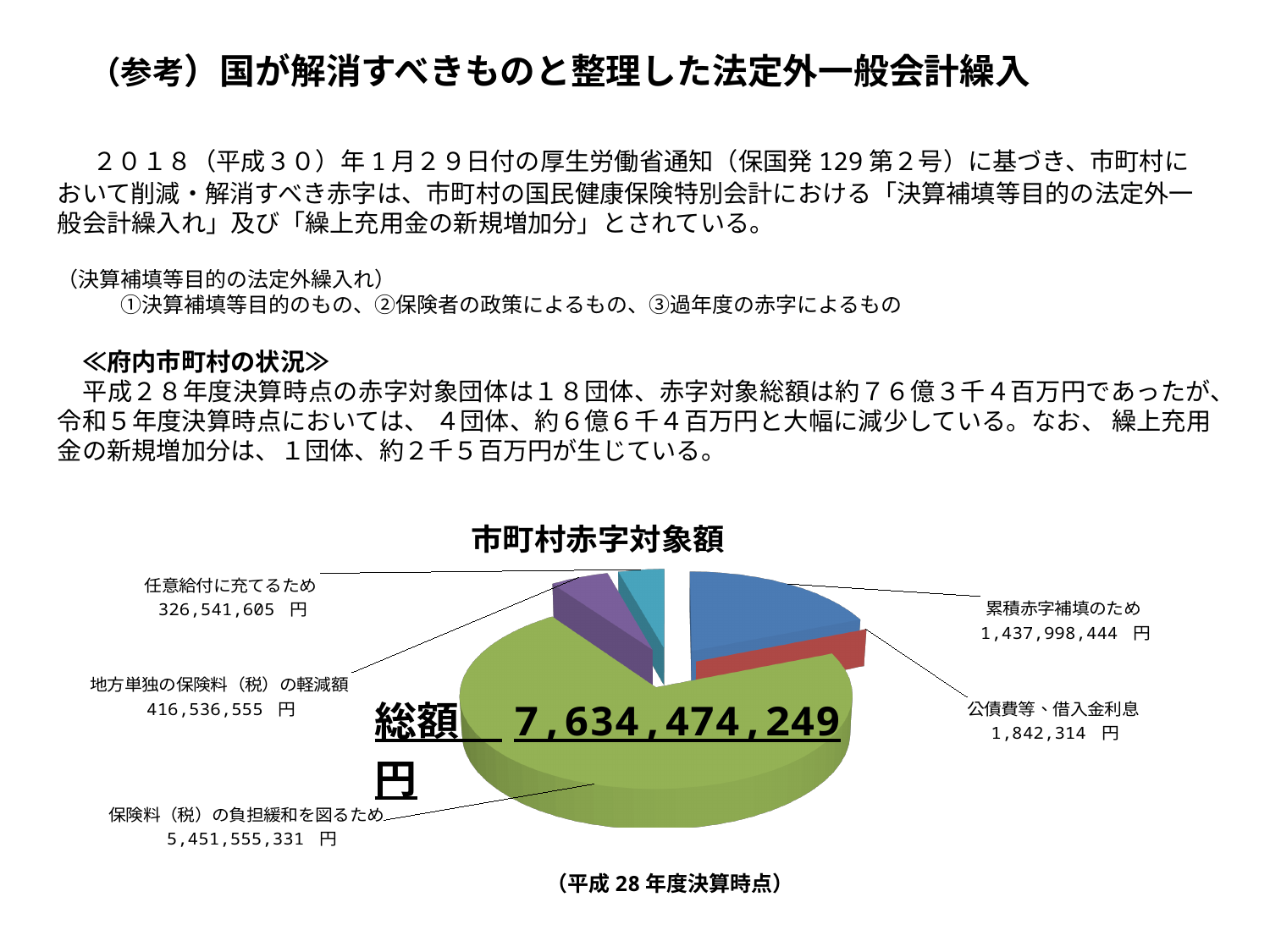
円グラフ「市町村赤字対象額」で、「公債費等、借入金利息」の金額はいくらですか？ 1,842,314 円 円グラフ「市町村赤字対象額」で、最も金額が大きい項目はどれですか？ 保険料（税）の負担緩和を図るため 円グラフ「市町村赤字対象額」で、「累積赤字補填のため」の金額はいくらですか？ 1,437,998,444 円 円グラフ「市町村赤字対象額」で、「任意給付に充てるため」の金額はいくらですか？ 326,541,605 円 円グラフ「市町村赤字対象額」に示されている総額はいくらですか？ 7,634,474,249 円 円グラフ「市町村赤字対象額」で、「地方単独の保険料（税）の軽減額」と「任意給付に充てるため」ではどちらが大きいですか？ 地方単独の保険料（税）の軽減額 円グラフ「市町村赤字対象額」で、「累積赤字補填のため」と「地方単独の保険料（税）の軽減額」の差はいくらですか？ 1,021,461,889 円 円グラフ「市町村赤字対象額」には項目がいくつありますか？ 5 円グラフ「市町村赤字対象額」で、「地方単独の保険料（税）の軽減額」の金額はいくらですか？ 416,536,555 円 スライドに示されているグラフの種類は何ですか？ 円グラフ 円グラフ「市町村赤字対象額」で、最も金額が小さい項目はどれですか？ 公債費等、借入金利息 円グラフ「市町村赤字対象額」で、「保険料（税）の負担緩和を図るため」の金額はいくらですか？ 5,451,555,331 円